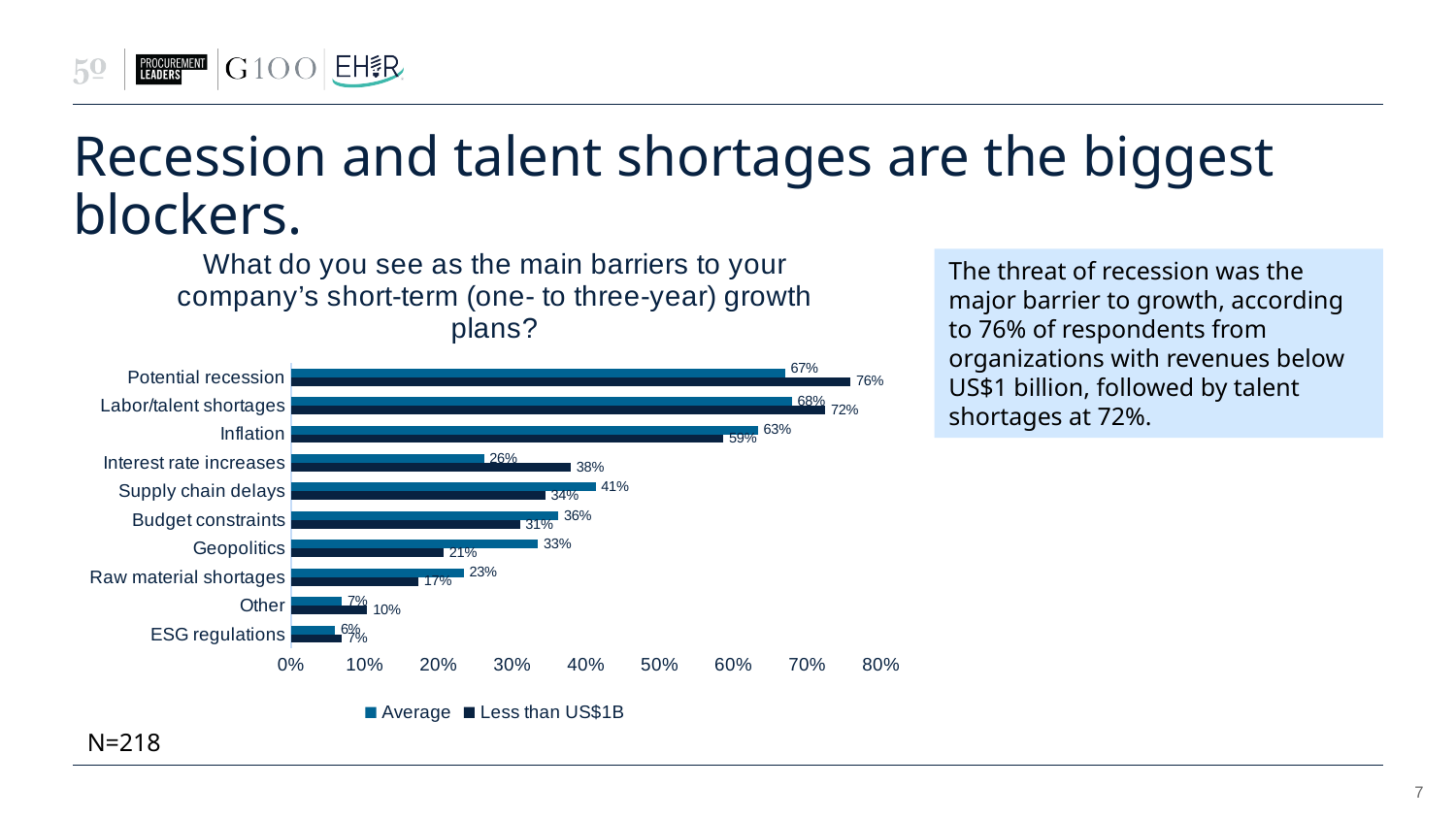
How many series does the legend list? 2 Is the Average value for Budget constraints greater or less than 30%? greater What is the difference between the Less than US$1B and Average values for Potential recession? 9% What is the value for Potential recession in the Less than US$1B series? 76% What is the difference between the Average and Less than US$1B values for Geopolitics? 12% How many categories are shown on the chart? 10 What is the value for Interest rate increases in the Less than US$1B series? 38% Which category has the highest value in the Less than US$1B series? Potential recession What kind of chart is shown on the slide? Bar chart Which category has the lowest Average value? ESG regulations What is the Average value for Supply chain delays? 41% For Inflation, which series has the larger value, Average or Less than US$1B? Average